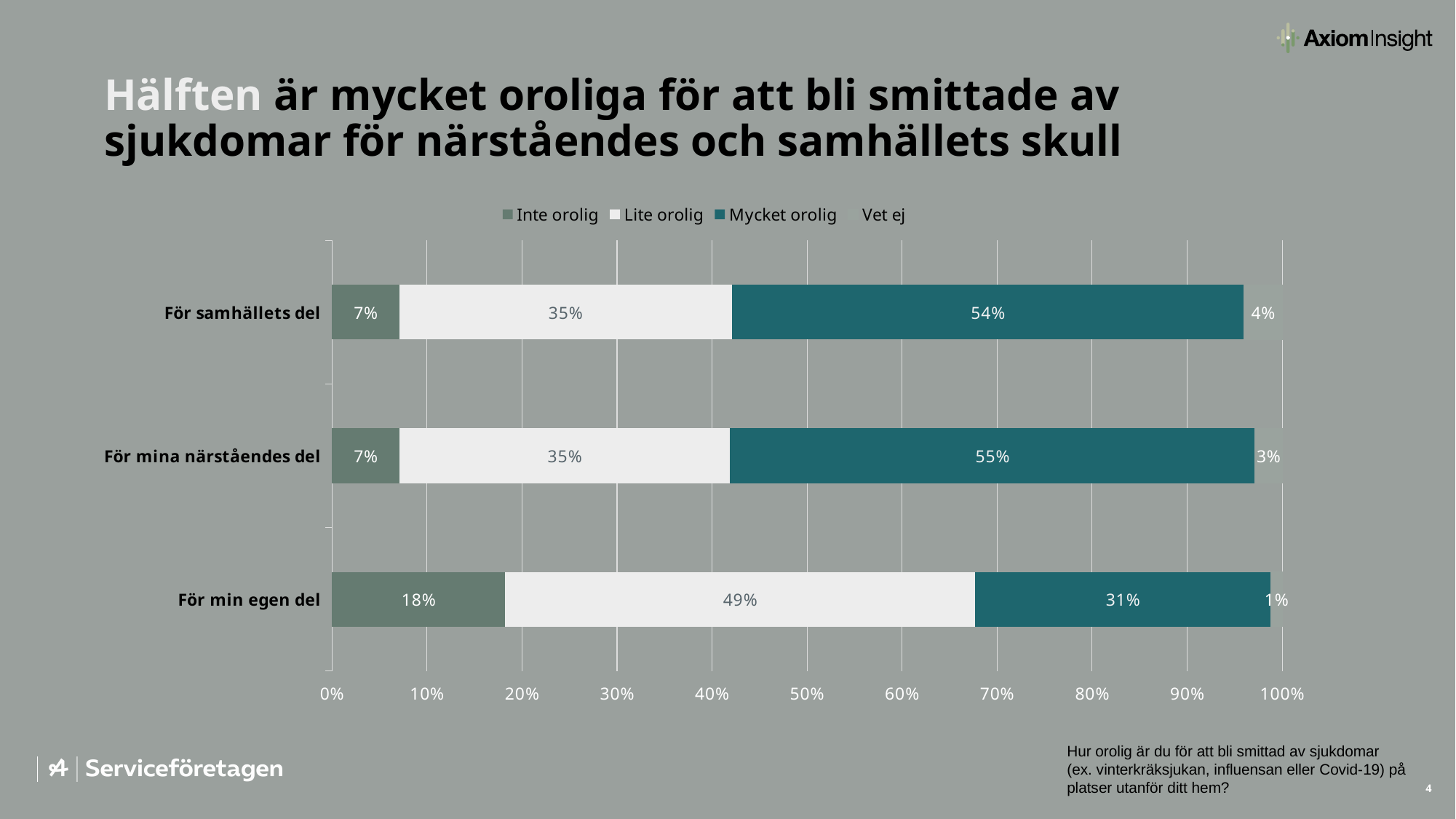
What kind of chart is shown on the slide? Stacked bar chart What percentage of respondents answered "Inte orolig" for "För min egen del"? 18% What percentage of respondents answered "Lite orolig" for "För mina närståendes del"? 35% How many series does the legend list? 4 What is the difference between the "Mycket orolig" share for "För samhällets del" and for "För min egen del"? 23 percentage points Which category has the highest "Mycket orolig" share? För mina närståendes del Is the "Lite orolig" share larger for "För min egen del" or for "För samhällets del"? För min egen del What is the total of the stacked bar for "För min egen del"? 99% What percentage of respondents answered "Vet ej" for "För min egen del"? 1% What percentage of respondents answered "Mycket orolig" for "För samhällets del"? 54% Which category has the lowest "Mycket orolig" share? För min egen del How many categories are shown on the chart? 3